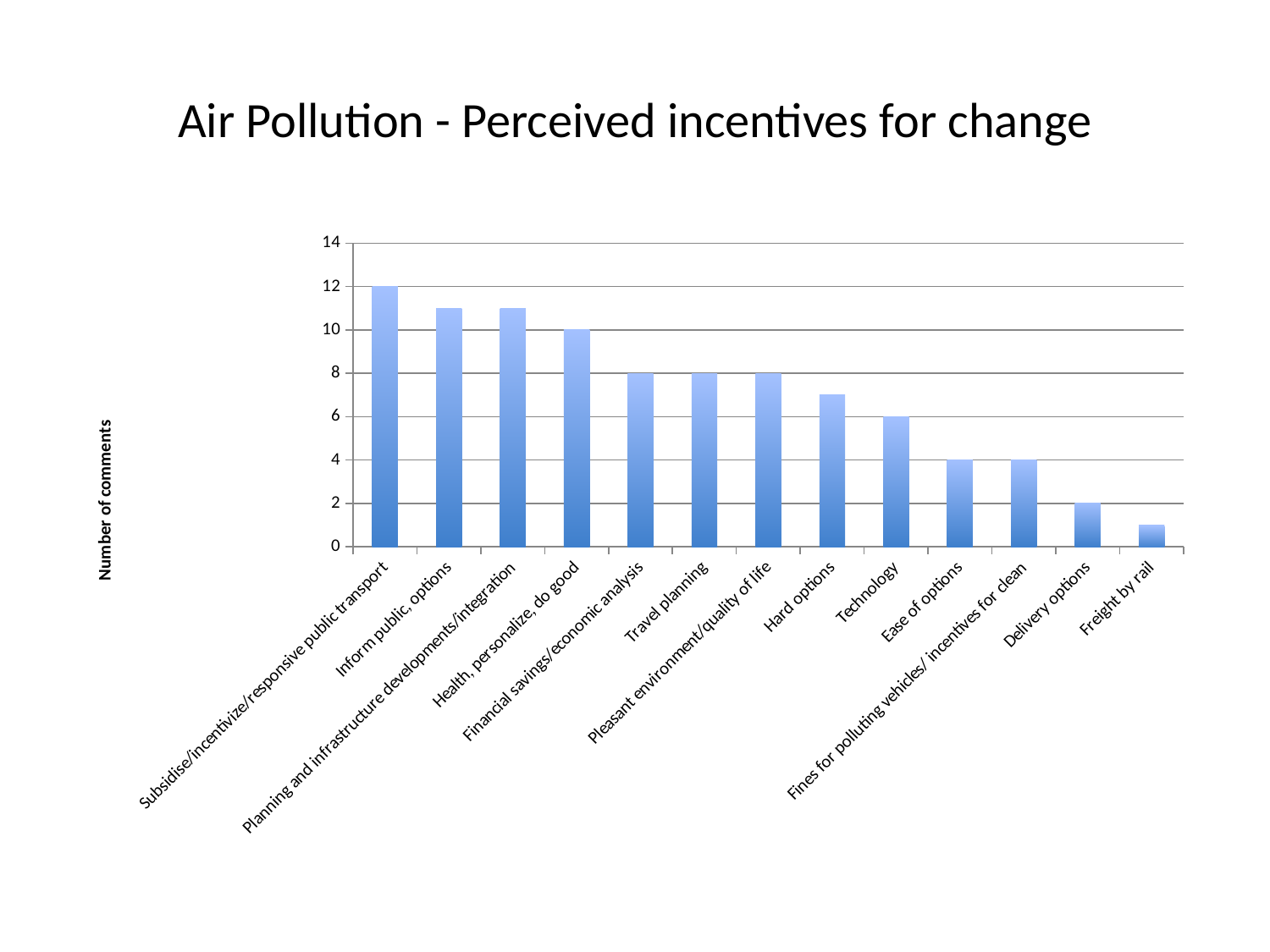
Do the values generally rise or fall moving from left to right along the x axis? Fall Is the value for Hard options greater or less than 8? less What type of chart is shown on the slide? Bar chart Which category has the lowest number of comments? Freight by rail What is the difference in number of comments between Subsidise/incentivize/responsive public transport and Technology? 6 Which category has the highest number of comments? Subsidise/incentivize/responsive public transport What is the number of comments for Delivery options? 2 What is the number of comments for Subsidise/incentivize/responsive public transport? 12 What is the number of comments for Technology? 6 Is the value for Inform public, options greater or less than 10? greater What is the number of comments for Health, personalize, do good? 10 How many categories are plotted on the chart? 13